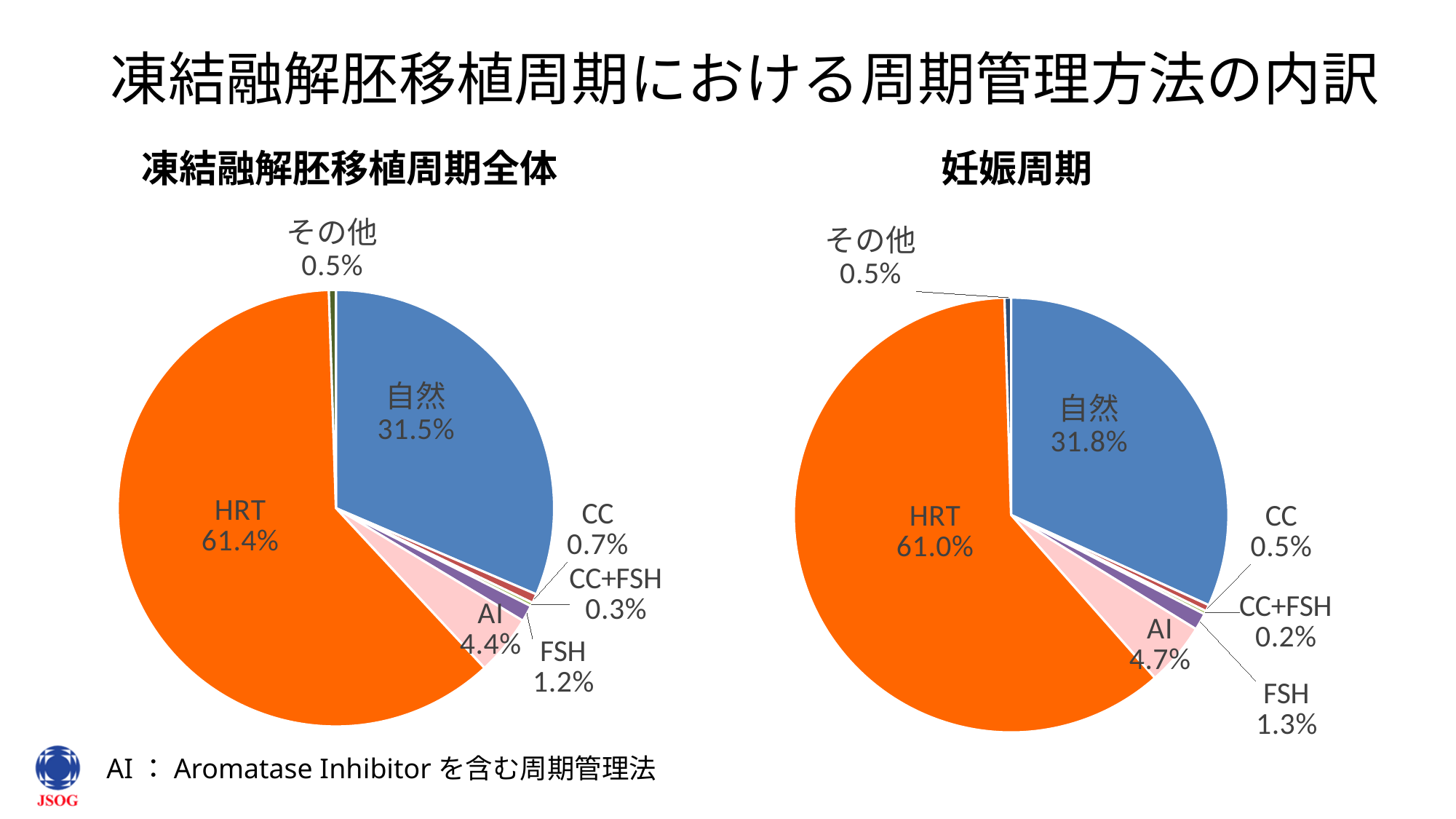
In the left pie chart (凍結融解胚移植周期全体), what share does HRT have? 61.4% In the left pie chart (凍結融解胚移植周期全体), which category has the largest share? HRT What kind of chart is used on this slide? Pie chart In the left pie chart (凍結融解胚移植周期全体), what share does AI have? 4.4% What is the title of the right chart? 妊娠周期 In the right pie chart (妊娠周期), what share does FSH have? 1.3% In the right pie chart (妊娠周期), which category has the smallest share? CC+FSH Is the HRT share larger in the left pie chart (凍結融解胚移植周期全体) or in the right pie chart (妊娠周期)? Left (凍結融解胚移植周期全体) In the right pie chart (妊娠周期), what share does 自然 have? 31.8% How many categories are shown in the right pie chart (妊娠周期)? 7 In the right pie chart (妊娠周期), what share does CC+FSH have? 0.2% In the left pie chart (凍結融解胚移植周期全体), what is the difference between the HRT share and the 自然 share? 29.9%